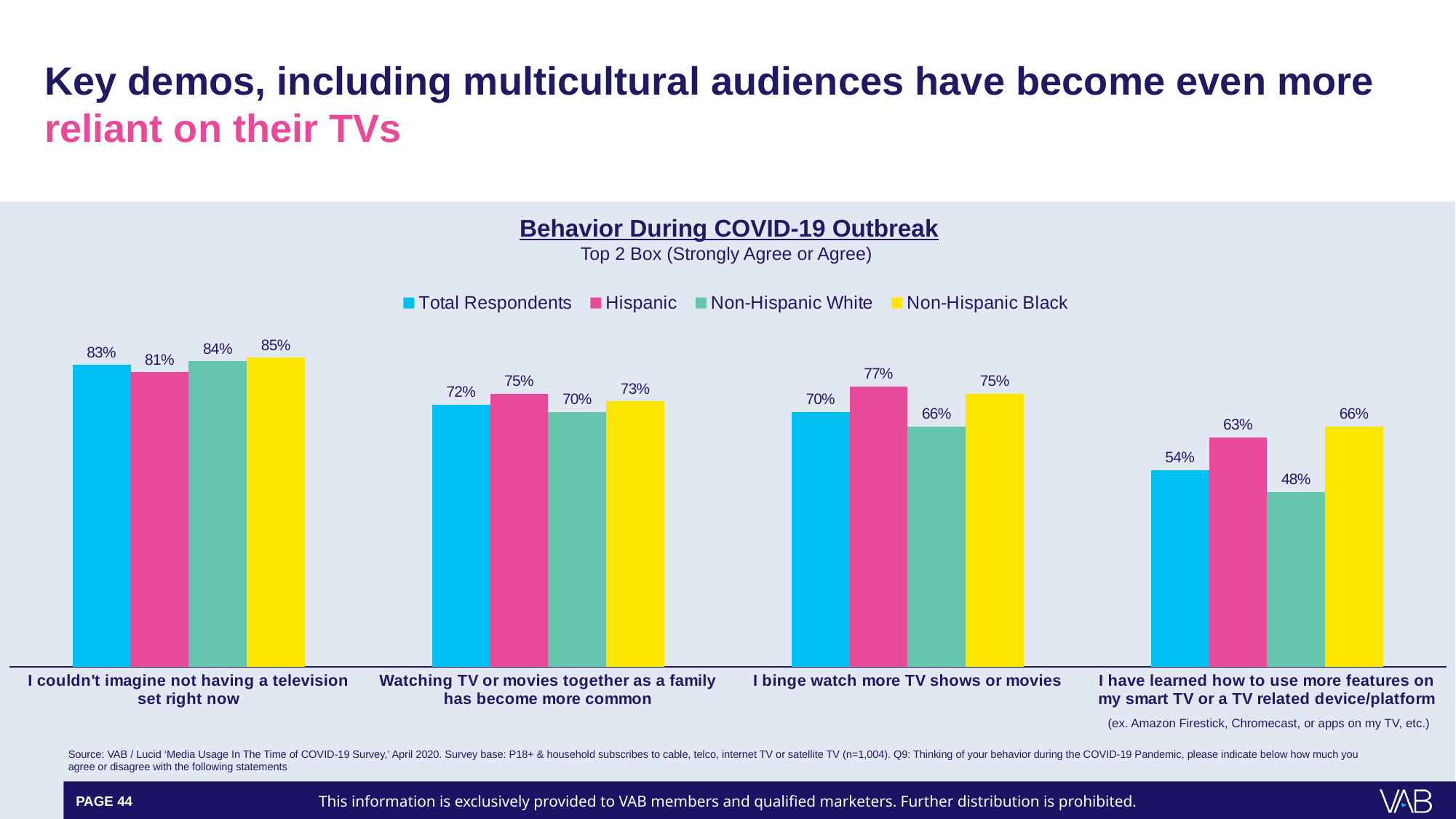
Do the Total Respondents values rise or fall across the categories from left to right? Fall What is the value for Non-Hispanic White respondents for "I have learned how to use more features on my smart TV or a TV related device/platform"? 48% What is the Total Respondents value for "Watching TV or movies together as a family has become more common"? 72% What percentage of Hispanic respondents agreed with "I binge watch more TV shows or movies"? 77% Which group has the highest value for "I couldn't imagine not having a television set right now"? Non-Hispanic Black How many statement categories are shown on the x axis? 4 How many series does the legend list? 4 What is the title of the chart? Behavior During COVID-19 Outbreak What kind of chart is shown on the slide? Bar chart What is the difference between the Hispanic and Non-Hispanic White values for "I binge watch more TV shows or movies"? 11 percentage points For "Watching TV or movies together as a family has become more common", which is larger: the Hispanic value or the Non-Hispanic Black value? Hispanic Which group has the lowest value for "I have learned how to use more features on my smart TV or a TV related device/platform"? Non-Hispanic White